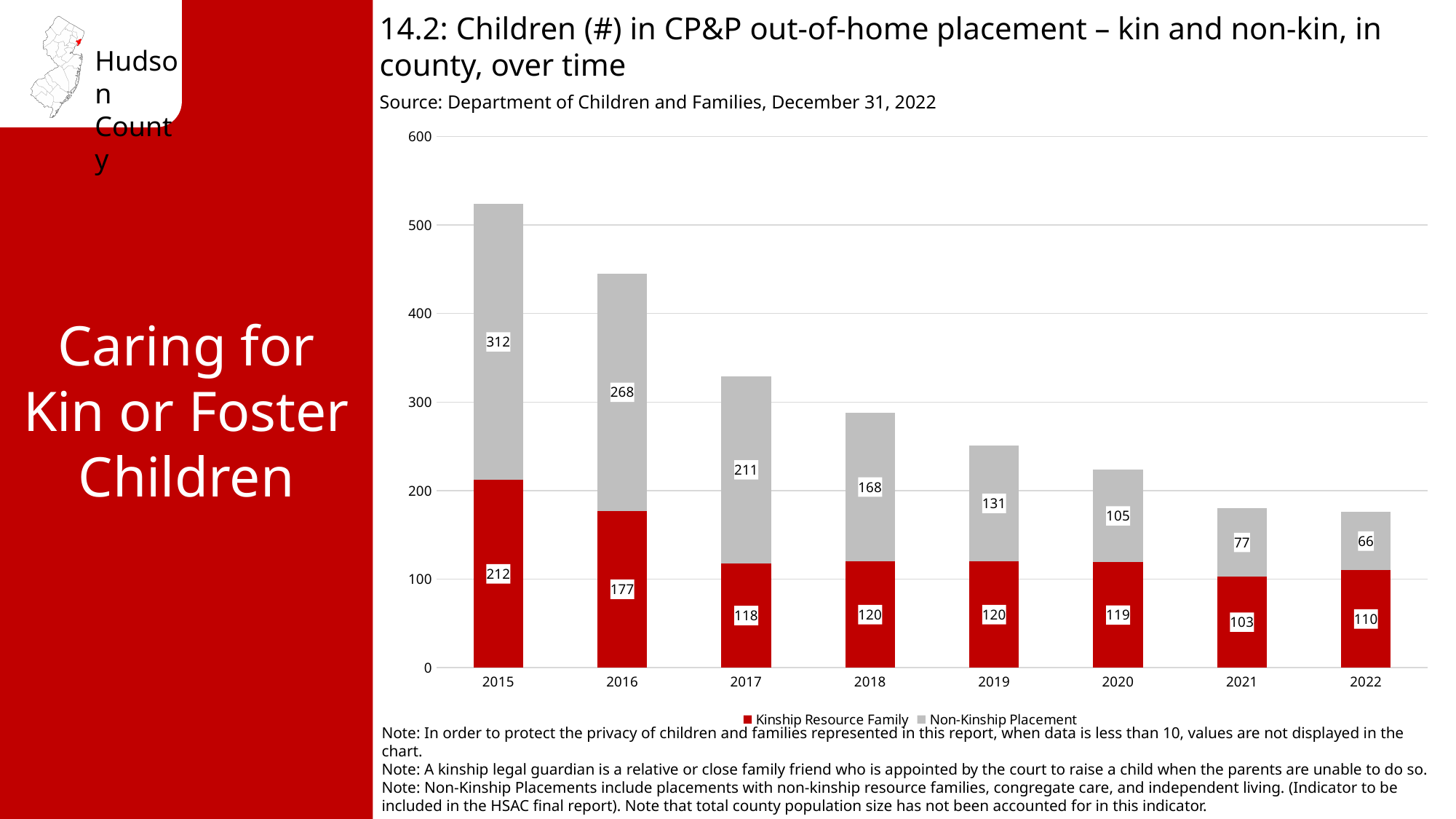
How many years are shown on the x axis? 8 What is the Non-Kinship Placement value for 2022? 66 What is the Non-Kinship Placement value for 2018? 168 What is the total of the stacked bar for 2020? 224 How many series does the legend list? 2 What kind of chart is shown on the slide? Stacked bar chart Which is larger, the Kinship Resource Family value for 2016 or for 2022? 2016 Which year has the highest Non-Kinship Placement value? 2015 What is the difference between the Non-Kinship Placement values for 2015 and 2016? 44 What is the Kinship Resource Family value for 2015? 212 Which year has the lowest Kinship Resource Family value? 2021 Is the total stacked bar for 2015 greater or less than 500? greater